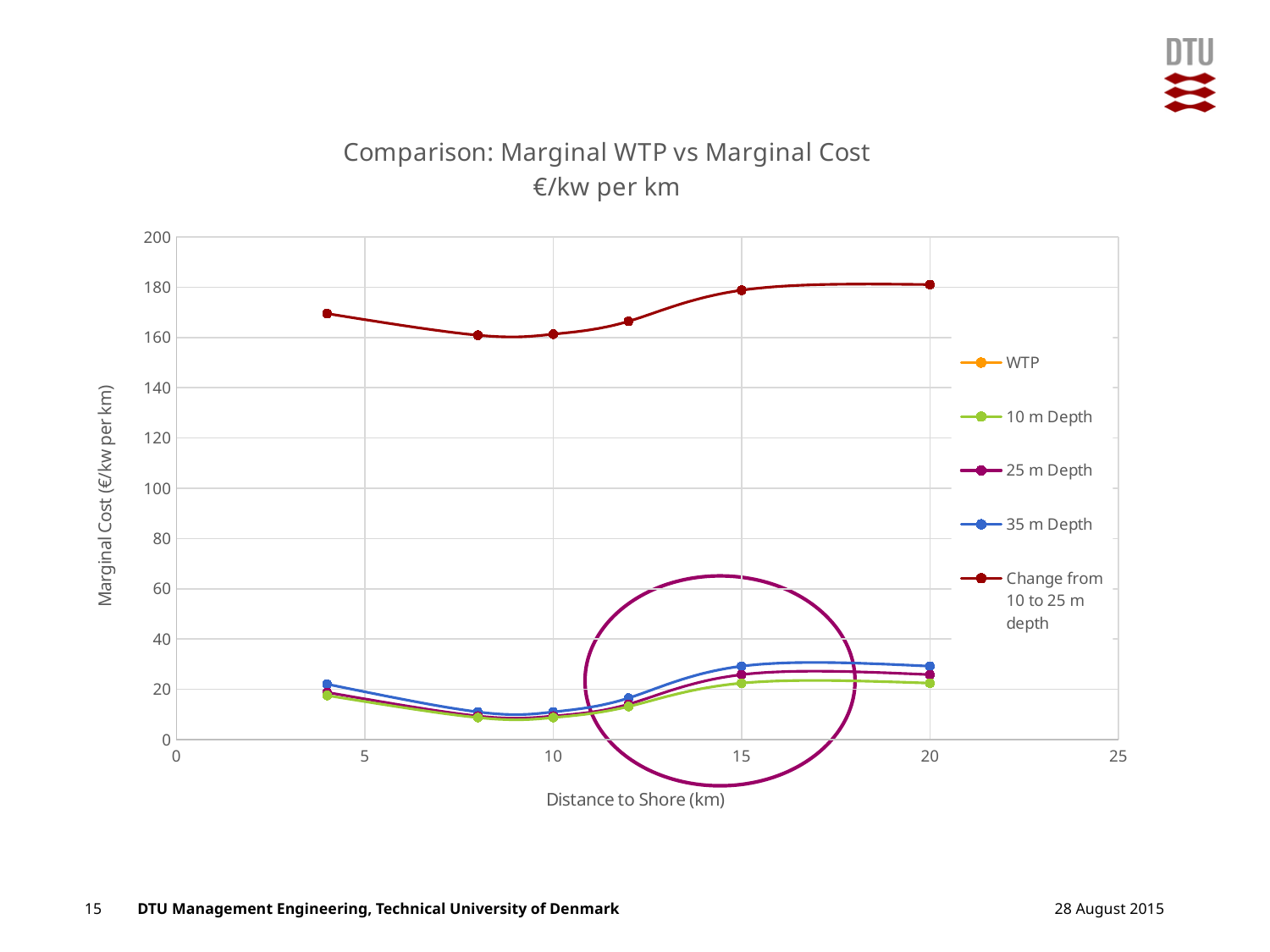
What kind of chart is shown on the slide? Line chart What is the label of the x axis? Distance to Shore (km) What is the title of the chart? Comparison: Marginal WTP vs Marginal Cost €/kw per km Is the value of the 'Change from 10 to 25 m depth' series at 20 km greater or less than 160? greater Is the value of the '10 m Depth' series at 8 km greater or less than 20? less How many data points are plotted for the '35 m Depth' series? 6 Is the value of the '35 m Depth' series at 15 km greater or less than 20? greater At 15 km, which is larger: the '35 m Depth' value or the '10 m Depth' value? 35 m Depth How many series does the legend list? 5 Does the 'Change from 10 to 25 m depth' series rise or fall between 10 km and 20 km? rise Which series has the highest values across the chart? Change from 10 to 25 m depth